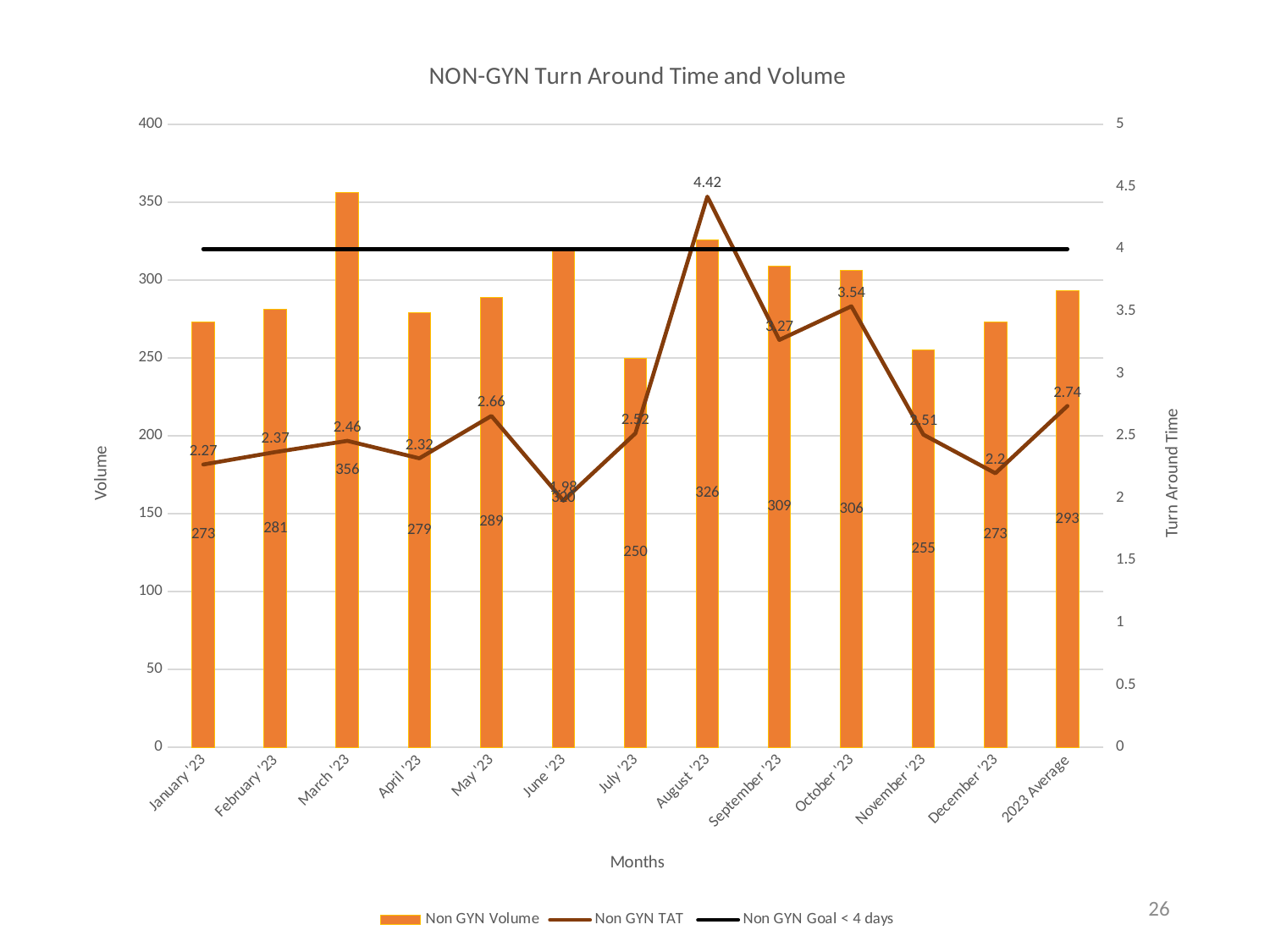
How many series does the legend list? 3 What is the title of the right-hand vertical axis? Turn Around Time Which month has the highest Non GYN Volume? March '23 What is the Non GYN TAT value for August '23? 4.42 Which has the higher Non GYN Volume, September '23 or October '23? September '23 Which month has the lowest Non GYN TAT? June '23 What is the Non GYN TAT value for the 2023 Average? 2.74 How many categories are shown on the x axis? 13 What is the difference between the Non GYN Volume for August '23 and July '23? 76 Which month has the lowest Non GYN Volume? July '23 What is the Non GYN Volume for March '23? 356 Is the Non GYN TAT for August '23 greater or less than 4? greater